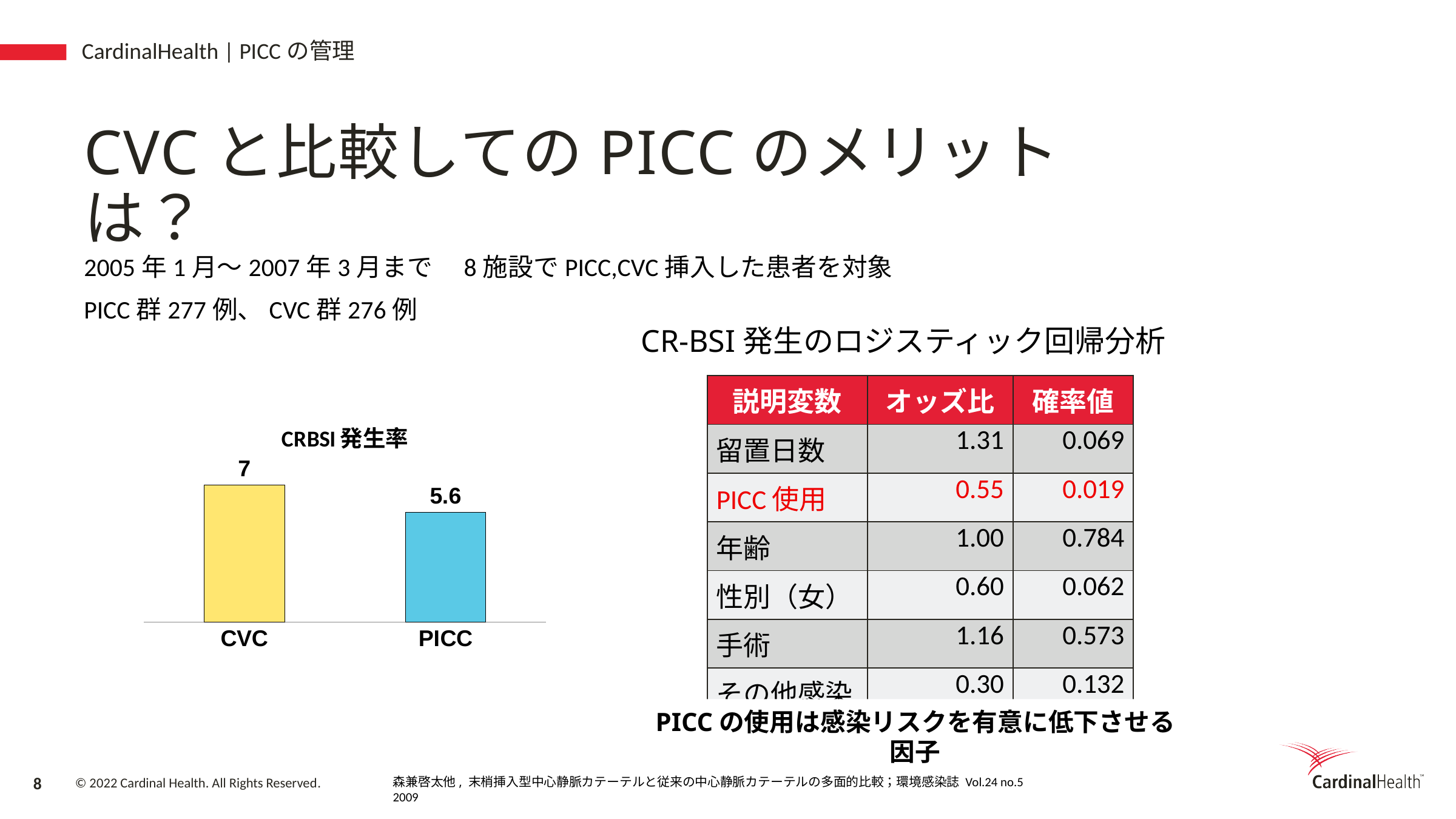
Which category has the higher CRBSI 発生率, CVC or PICC? CVC What is the title of the bar chart on the slide? CRBSI 発生率 What kind of chart is the CRBSI 発生率 chart? Bar chart What is the CRBSI 発生率 value for PICC? 5.6 What colour is the CVC bar in the CRBSI 発生率 chart? Yellow What is the difference between the CRBSI 発生率 for CVC and for PICC? 1.4 Which category has the lowest CRBSI 発生率? PICC Which category has the highest CRBSI 発生率? CVC How many categories are shown in the CRBSI 発生率 chart? 2 What is the CRBSI 発生率 value for CVC? 7